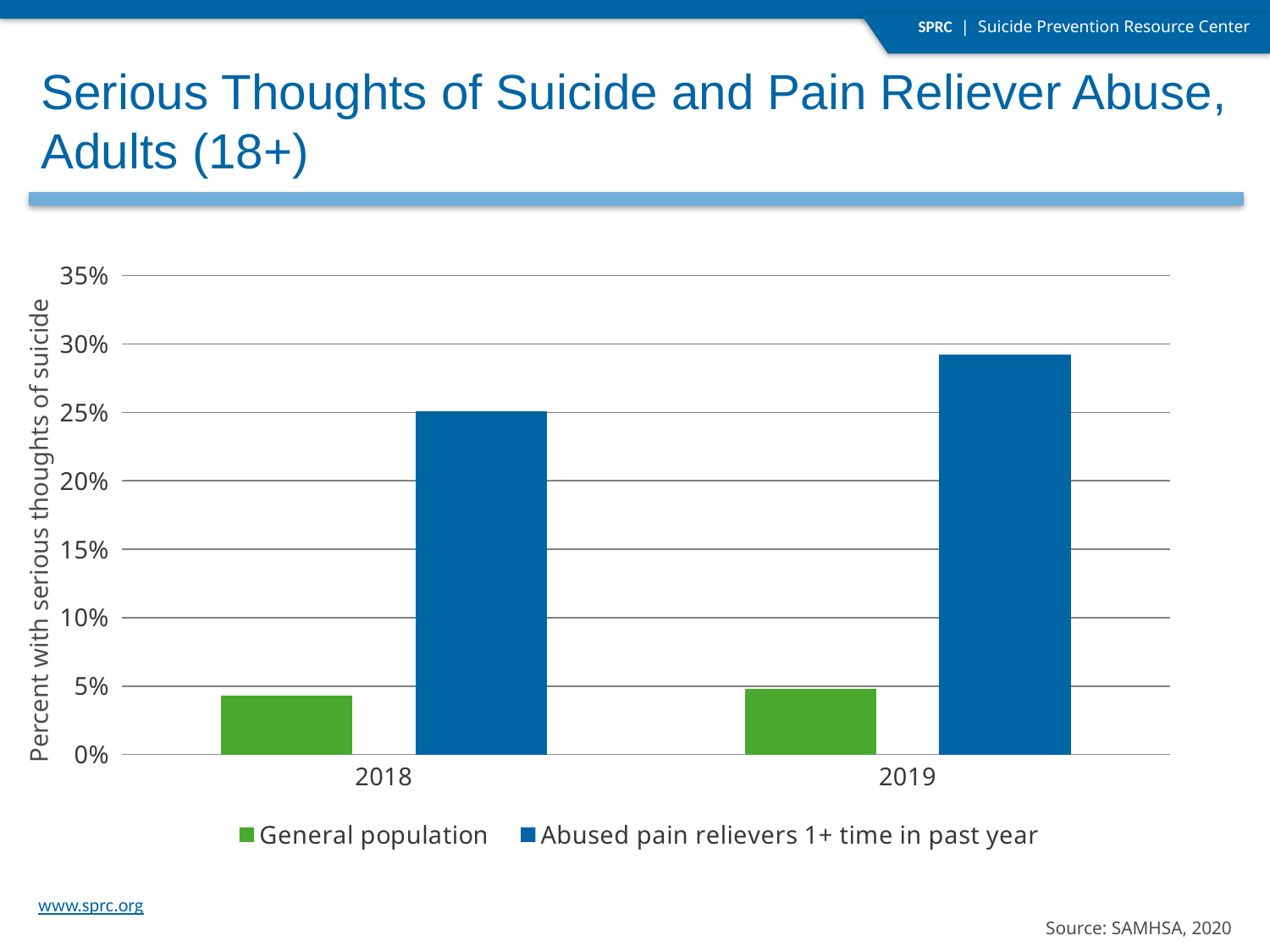
What kind of chart is shown on the slide? bar chart Which colour represents the General population series in the chart? green How many years are shown on the x axis of the chart? 2 How many series does the chart's legend list? 2 Is the value for Abused pain relievers 1+ time in past year in 2018 greater or less than 20%? greater Which series has the higher value in 2019, General population or Abused pain relievers 1+ time in past year? Abused pain relievers 1+ time in past year Is the value for General population in 2018 greater or less than 5%? less Which bar is the shortest in the chart? General population, 2018 Which bar is the tallest in the chart? Abused pain relievers 1+ time in past year, 2019 Does the value for Abused pain relievers 1+ time in past year rise or fall from 2018 to 2019? rise What is the label on the vertical axis of the chart? Percent with serious thoughts of suicide Is the value for Abused pain relievers 1+ time in past year in 2019 greater or less than 25%? greater